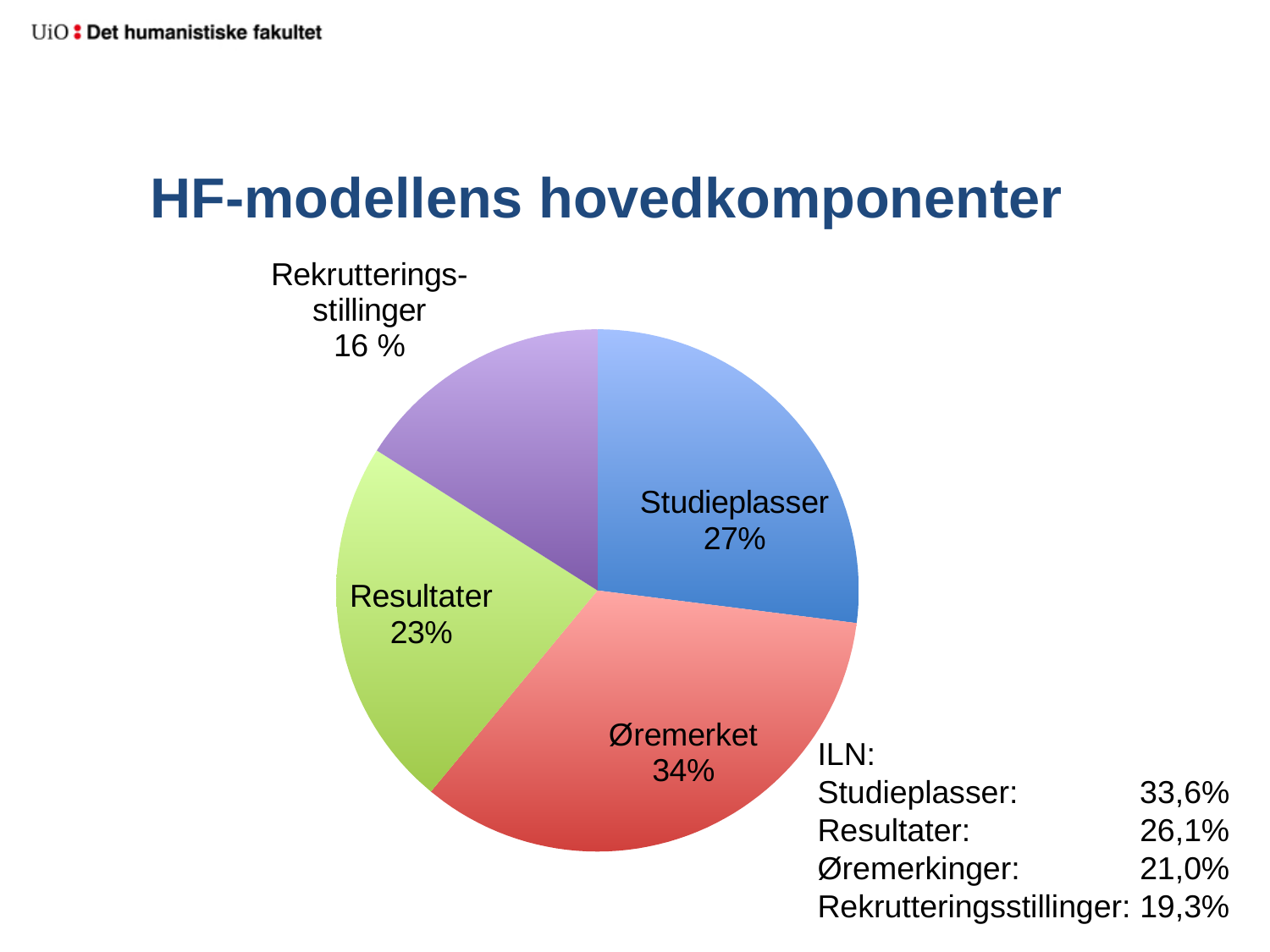
Which is larger, Resultater or Studieplasser? Studieplasser What share of the pie does Øremerket have? 34% Which slice of the pie is the smallest? Rekrutteringsstillinger Which slice of the pie is the largest? Øremerket What is the difference in percentage points between Øremerket and Studieplasser? 7 What kind of chart is shown on the slide? pie chart What colour is the Resultater slice? green How many slices does the pie chart have? 4 What share of the pie does Studieplasser have? 27% What is the title of the slide containing the pie chart? HF-modellens hovedkomponenter What share of the pie does Resultater have? 23%